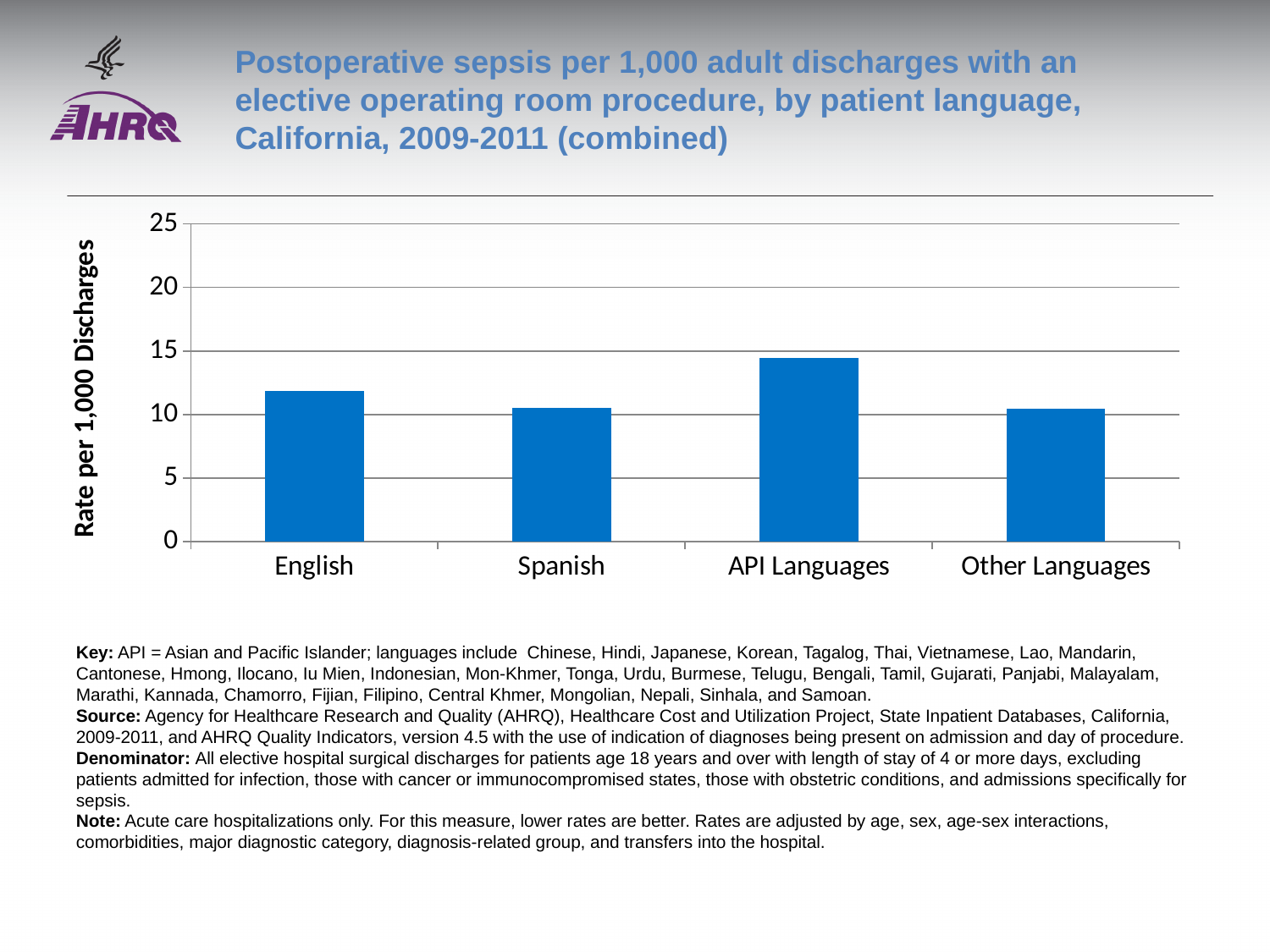
Is the rate for English greater or less than 15 per 1,000 discharges? less Is the rate for English greater or less than 10 per 1,000 discharges? greater Which is larger, the rate for English or the rate for Other Languages? English Is the rate for Other Languages greater or less than 5 per 1,000 discharges? greater Which is larger, the rate for API Languages or the rate for Spanish? API Languages Which patient language category has the highest postoperative sepsis rate? API Languages What is the label on the vertical axis of the chart? Rate per 1,000 Discharges What kind of chart is shown on the slide? bar chart How many patient language categories are shown on the x axis? 4